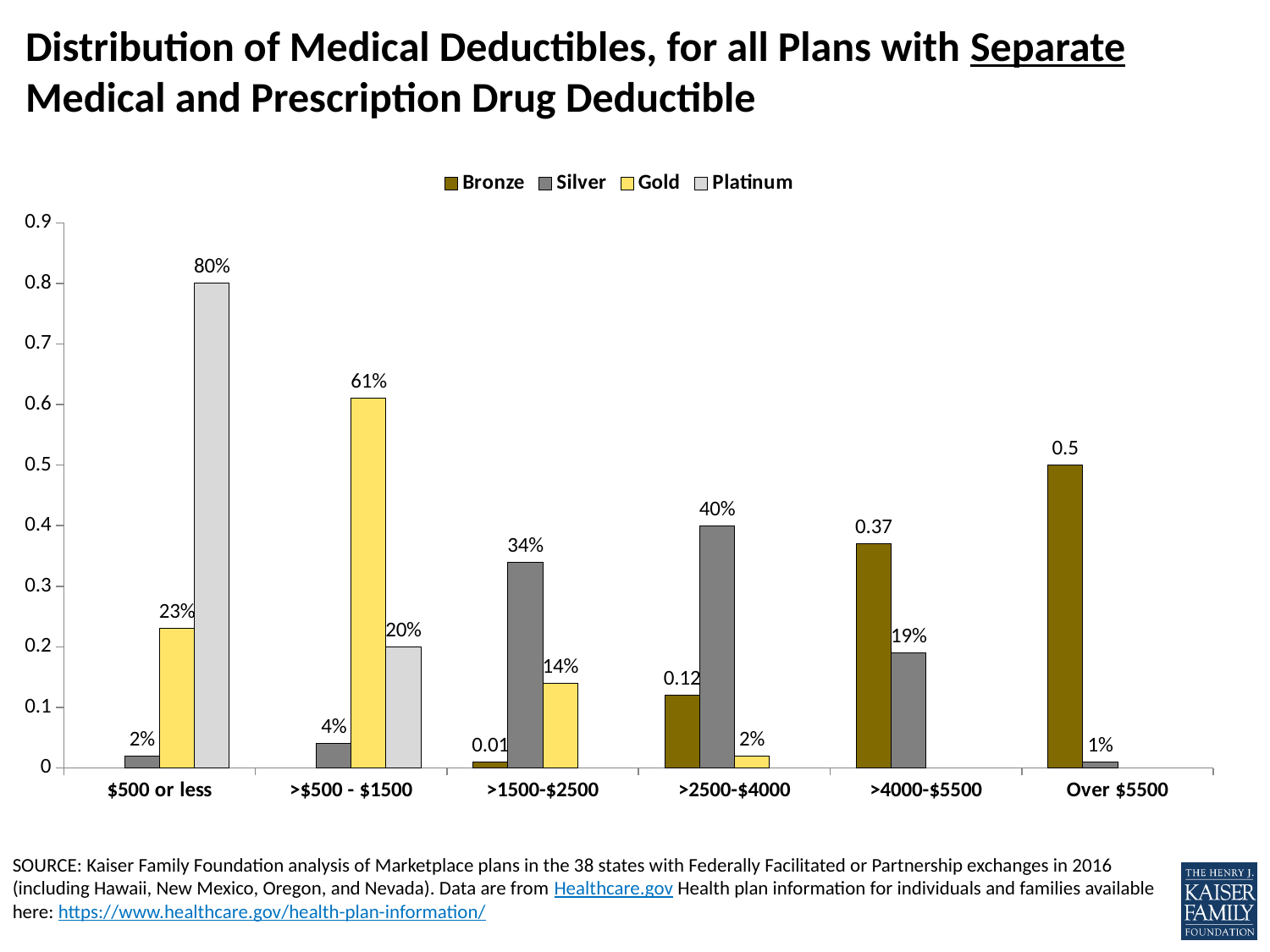
What is the value for Platinum in the "$500 or less" category? 80% Do the Bronze values rise or fall as the deductible categories increase along the x axis? rise What is the difference between the Platinum and Gold values in the "$500 or less" category? 57% In which category is the Silver value highest? >2500-$4000 What is the value for Gold in the ">$500 - $1500" category? 61% How many deductible categories are shown on the x axis? 6 In which category is the Platinum value highest? $500 or less What is the value for Bronze in the "Over $5500" category? 0.5 Which is larger in the ">$500 - $1500" category, Gold or Platinum? Gold What is the value for Silver in the ">4000-$5500" category? 19% How many series does the legend list? 4 What is the value for Bronze in the ">2500-$4000" category? 0.12